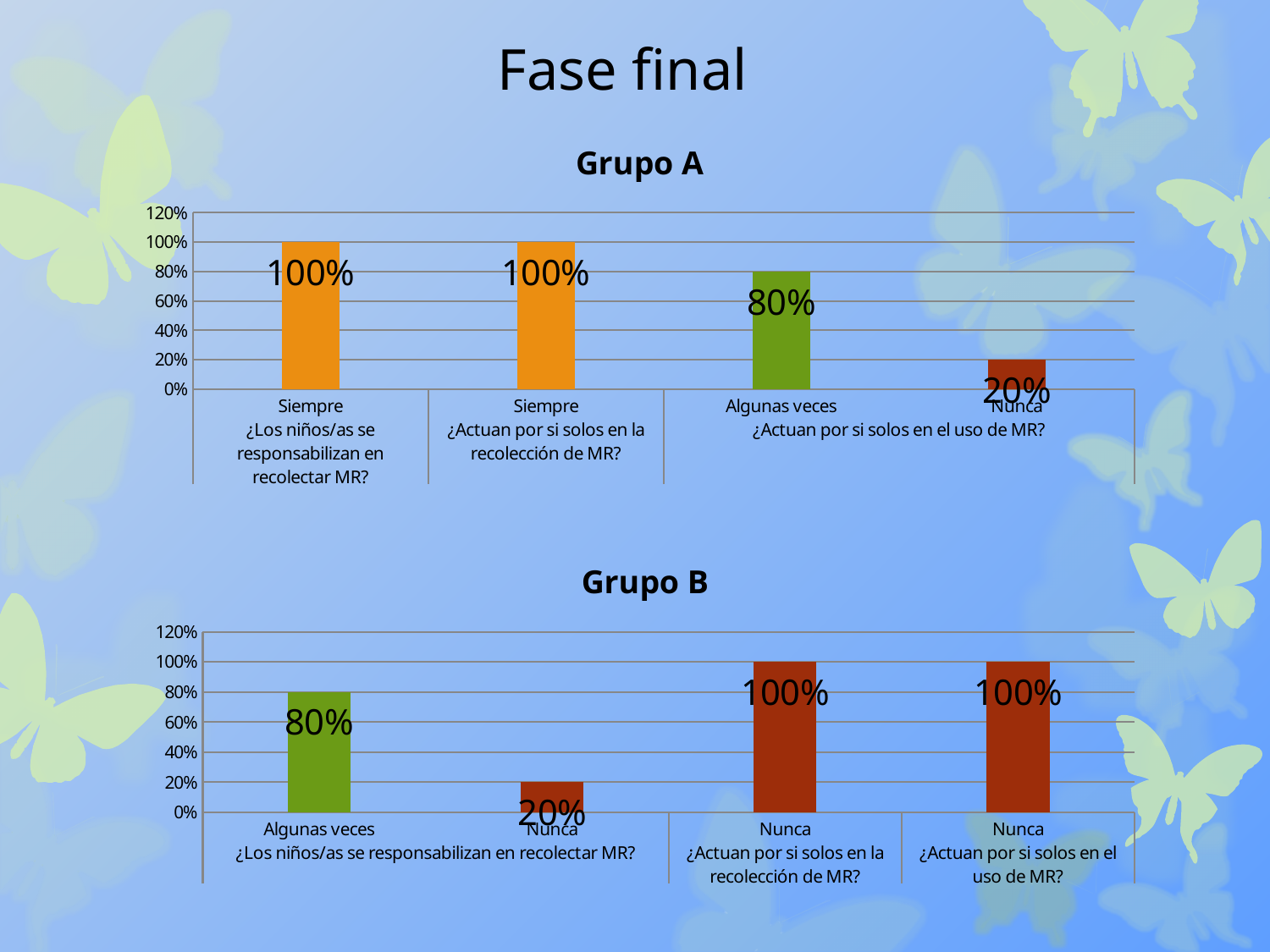
In the Grupo A chart, what is the value for "Siempre" under "¿Los niños/as se responsabilizan en recolectar MR?"? 100% In the Grupo B chart, which is larger: the "Algunas veces" value or the "Nunca" value for "¿Los niños/as se responsabilizan en recolectar MR?"? Algunas veces In the Grupo A chart, what is the value for "Algunas veces" under "¿Actuan por si solos en el uso de MR?"? 80% In the Grupo A chart, what is the difference between the "Algunas veces" and "Nunca" values for "¿Actuan por si solos en el uso de MR?"? 60% In the Grupo A chart, which category has the lowest value? Nunca (¿Actuan por si solos en el uso de MR?) What kind of chart is the Grupo B chart? Bar chart In the Grupo B chart, what is the value for "Nunca" under "¿Los niños/as se responsabilizan en recolectar MR?"? 20% In the Grupo B chart, what is the value for "Algunas veces" under "¿Los niños/as se responsabilizan en recolectar MR?"? 80% In the Grupo A chart, what is the value for "Nunca" under "¿Actuan por si solos en el uso de MR?"? 20% What is the title of the upper chart on the slide? Grupo A In the Grupo A chart, how many bars are plotted? 4 In the Grupo B chart, what is the value for "Nunca" under "¿Actuan por si solos en la recolección de MR?"? 100%